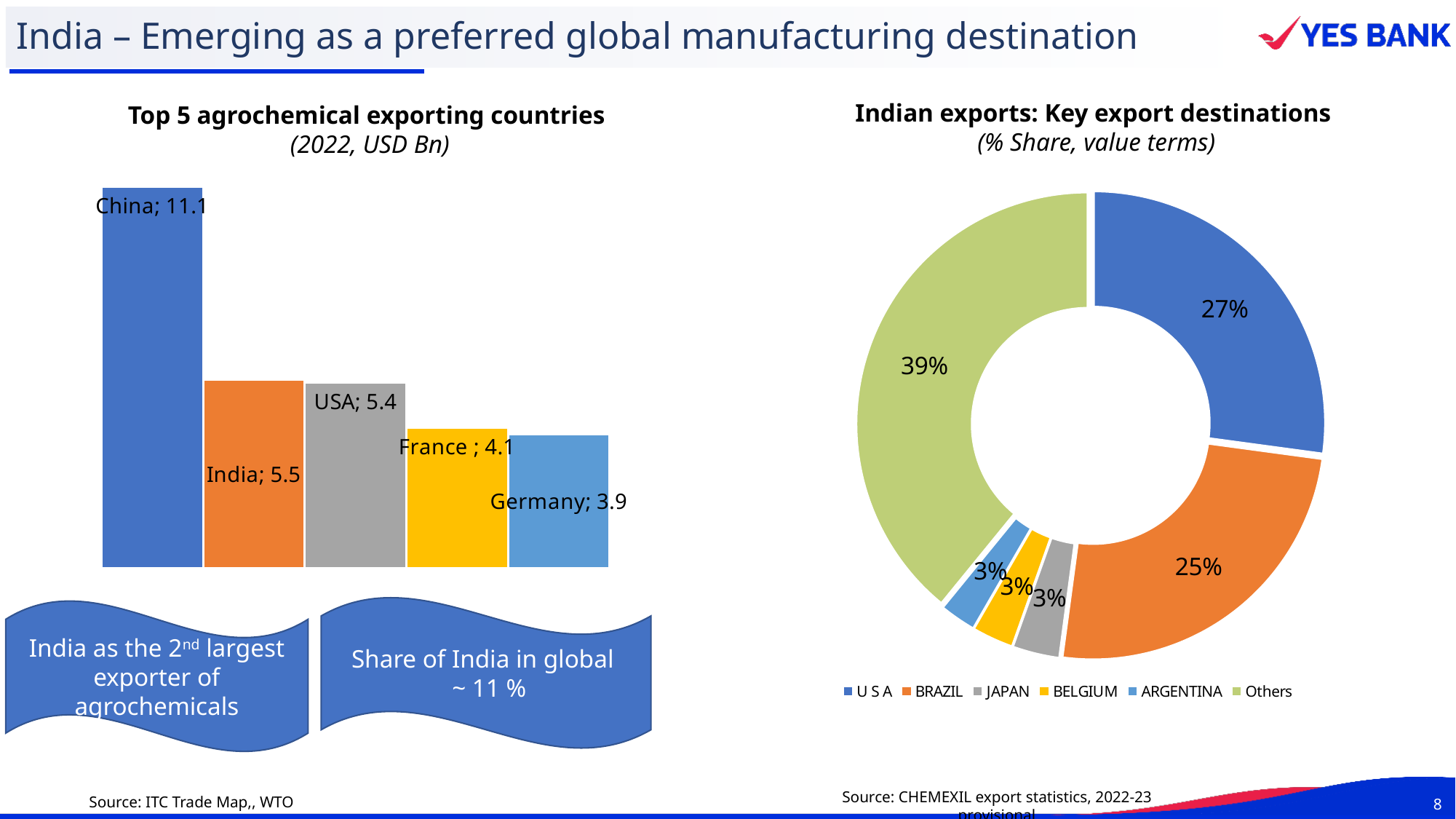
In the 'Indian exports: Key export destinations' chart, what share does U S A have? 27% In the 'Indian exports: Key export destinations' chart, what share does Brazil have? 25% How many categories does the legend of the 'Indian exports: Key export destinations' chart list? 6 What kind of chart is the 'Top 5 agrochemical exporting countries' chart? Bar chart In the 'Top 5 agrochemical exporting countries' chart, which country has the lowest value? Germany In the 'Top 5 agrochemical exporting countries' chart, what is the value for China? 11.1 In the 'Top 5 agrochemical exporting countries' chart, which is larger, the value for India or the value for USA? India In the 'Top 5 agrochemical exporting countries' chart, what is the value for Germany? 3.9 How many countries are shown in the 'Top 5 agrochemical exporting countries' chart? 5 In the 'Top 5 agrochemical exporting countries' chart, what is the difference between China's and India's values? 5.6 In the 'Top 5 agrochemical exporting countries' chart, which country has the highest value? China In the 'Indian exports: Key export destinations' chart, which category has the largest share? Others